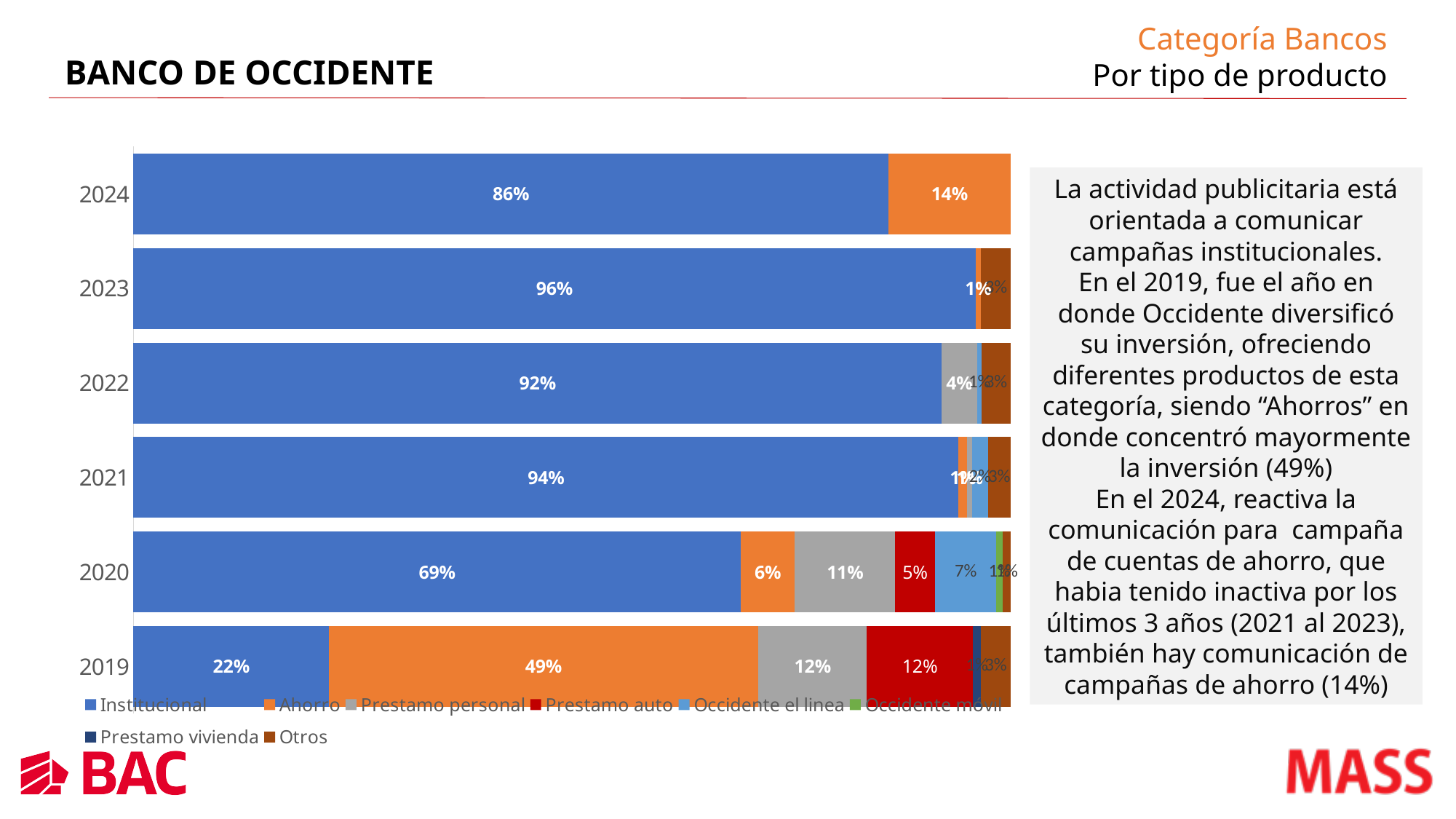
Which year has the highest Institucional share? 2023 What kind of chart is shown on the slide? Stacked bar chart How many series does the legend list? 8 What is the Ahorro share for 2019? 49% What is the Institucional share for 2024? 86% What is the Ahorro share for 2024? 14% How many years are shown on the chart? 6 What is the Prestamo personal share for 2020? 11% What is the difference between the Institucional share in 2023 and in 2024? 10% What is the Institucional share for 2020? 69% Which year has the lowest Institucional share? 2019 Which is larger in 2019, the Ahorro share or the Institucional share? Ahorro